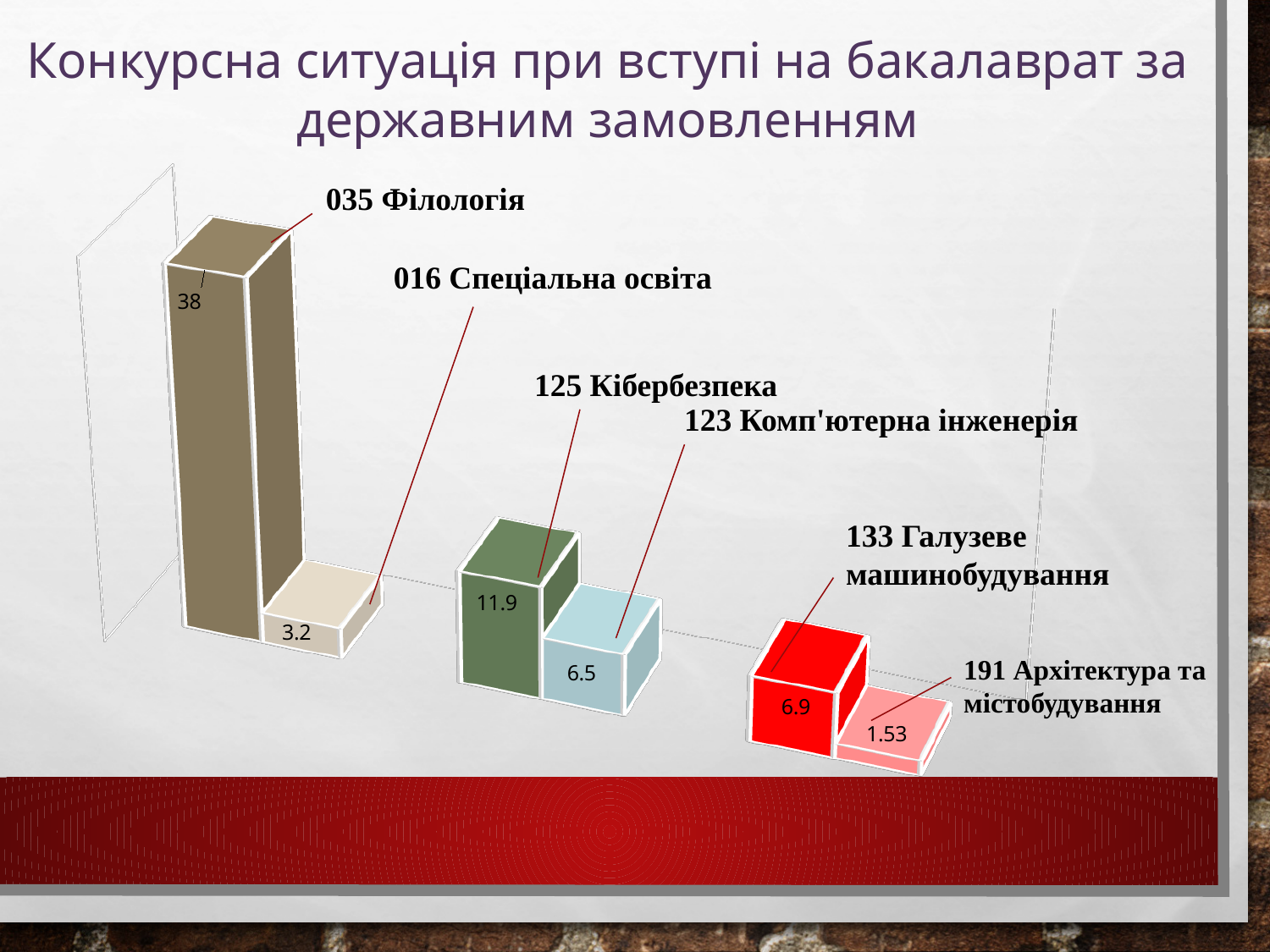
Which has a larger value, 133 Галузеве машинобудування or 123 Комп'ютерна інженерія? 133 Галузеве машинобудування What kind of chart is shown on the slide? Bar chart What is the value shown for 191 Архітектура та містобудування? 1.53 What is the difference between the values for 035 Філологія and 125 Кібербезпека? 26.1 What is the value shown for 035 Філологія? 38 What is the value shown for 125 Кібербезпека? 11.9 Which category has the lowest value? 191 Архітектура та містобудування What is the title of the slide? Конкурсна ситуація при вступі на бакалаврат за державним замовленням How many categories are shown in the chart? 6 What is the value shown for 123 Комп'ютерна інженерія? 6.5 What is the value shown for 016 Спеціальна освіта? 3.2 Which category has the highest value? 035 Філологія